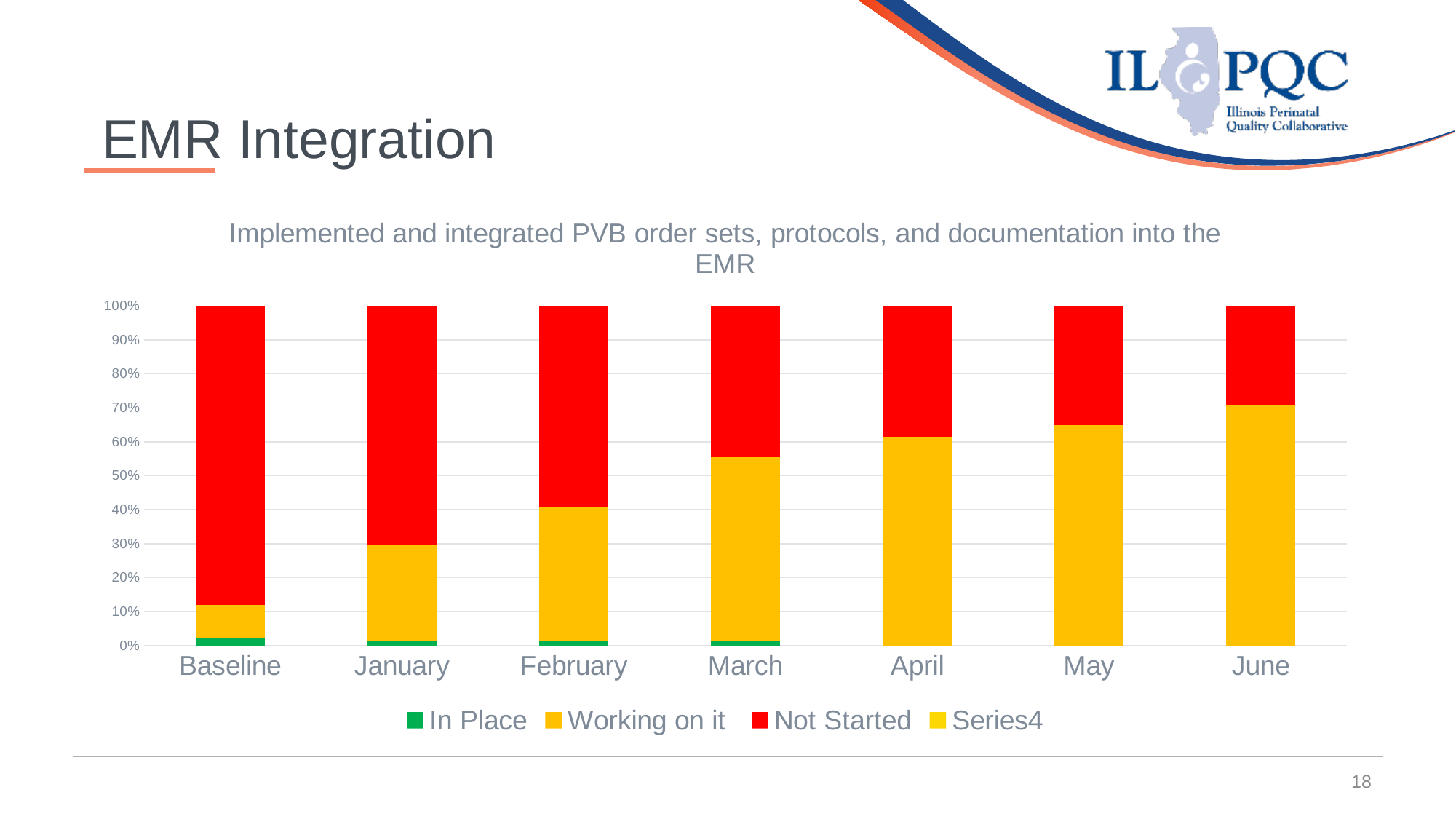
Does the 'Working on it' share rise or fall from Baseline to June? Rise Is the 'Working on it' share for June greater or less than 60%? greater In which category is the 'Not Started' share the highest? Baseline In which category is the 'Working on it' share the highest? June What kind of chart is shown on the slide? Stacked bar chart Is the 'Working on it' share for Baseline greater or less than 20%? less In which category is the 'Not Started' share the lowest? June Which has the larger 'Working on it' share, January or April? April Is the 'Not Started' share for Baseline greater or less than 80%? greater How many categories are shown along the x axis of the chart? 7 How many series does the chart's legend list? 4 Does the 'Not Started' share rise or fall from Baseline to June? Fall